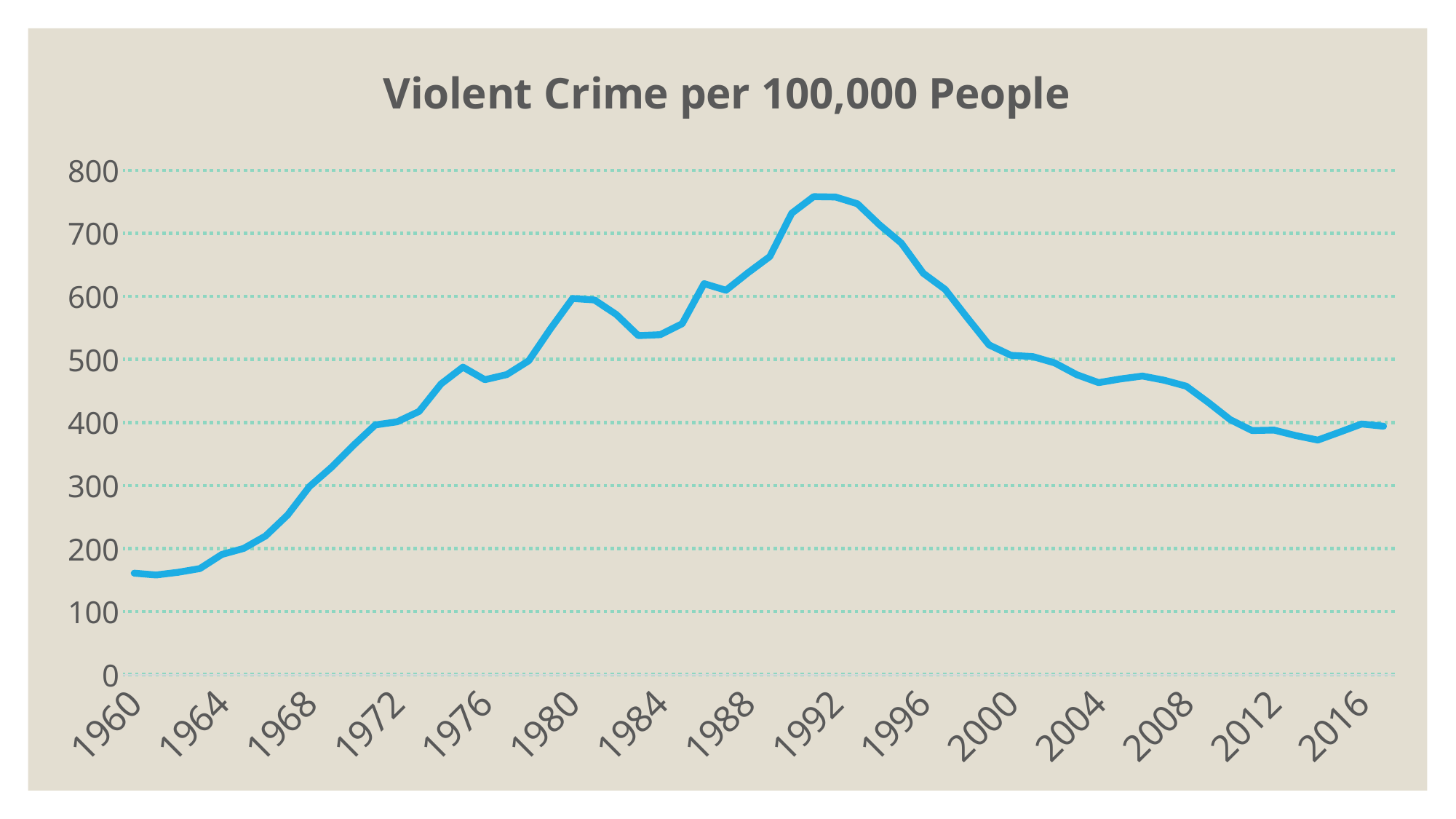
Is the value for 1992 greater or less than 700? greater Does the value rise or fall between 1960 and 1980? rise What kind of chart is shown on the slide? line chart Which is larger, the value for 1992 or the value for 2016? 1992 Does the value rise or fall between 1992 and 2012? fall Is the value for 1960 greater or less than 200? less Is the value for 1996 greater or less than 600? greater What is the title of the chart? Violent Crime per 100,000 People